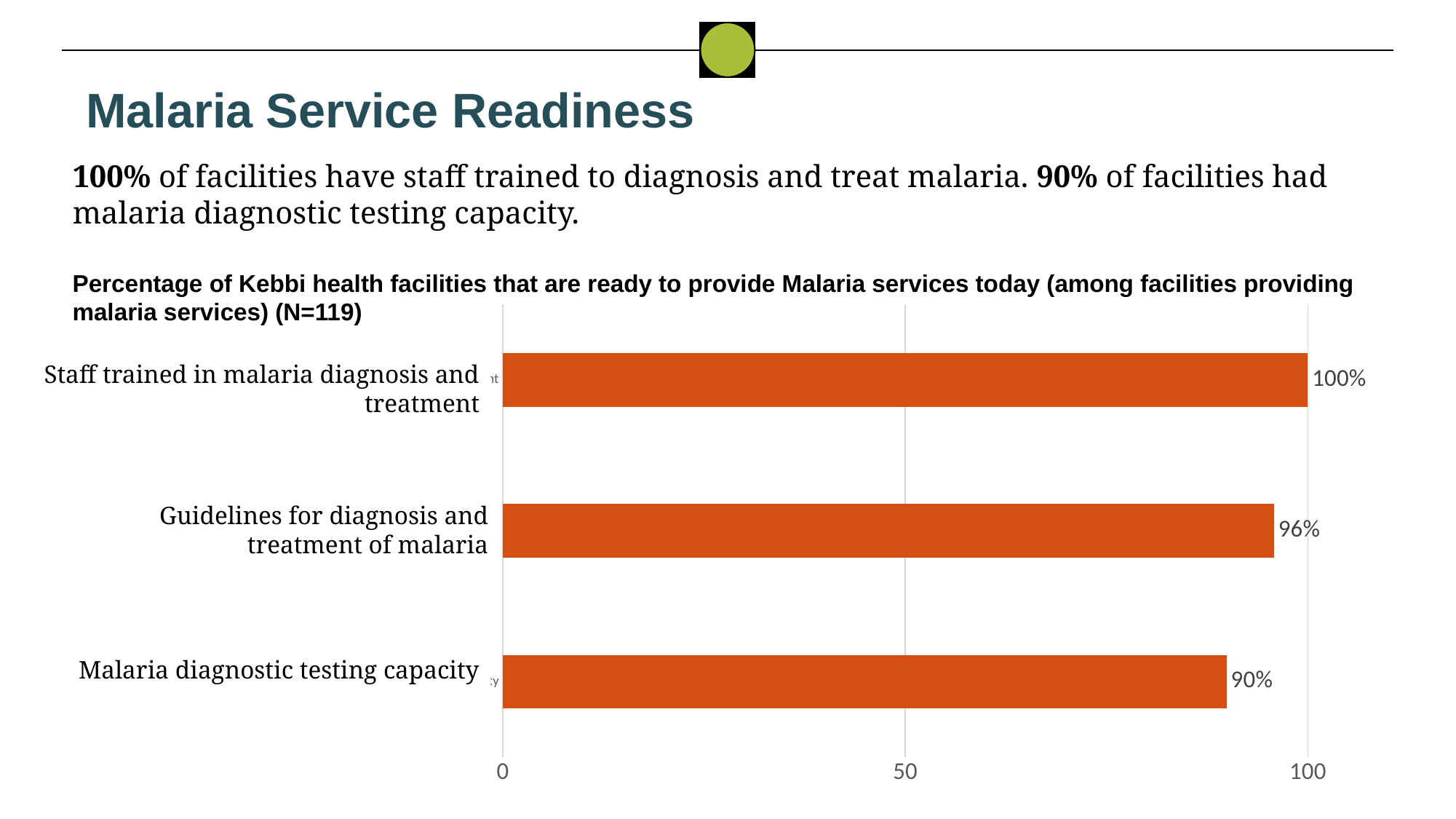
What percentage of facilities have staff trained in malaria diagnosis and treatment? 100% What percentage of facilities have malaria diagnostic testing capacity? 90% What kind of chart is shown on the slide? Bar chart Which category has the lowest percentage? Malaria diagnostic testing capacity What is the difference in percentage points between guidelines for diagnosis and treatment of malaria and malaria diagnostic testing capacity? 6 percentage points Which is larger: the value for guidelines for diagnosis and treatment of malaria or the value for malaria diagnostic testing capacity? Guidelines for diagnosis and treatment of malaria Is the value for malaria diagnostic testing capacity greater or less than 50? greater Which category has the highest percentage? Staff trained in malaria diagnosis and treatment What percentage of facilities have guidelines for diagnosis and treatment of malaria? 96% What is the sample size (N) stated in the chart title? 119 How many categories are shown in the chart? 3 What is the difference in percentage points between staff trained in malaria diagnosis and treatment and malaria diagnostic testing capacity? 10 percentage points